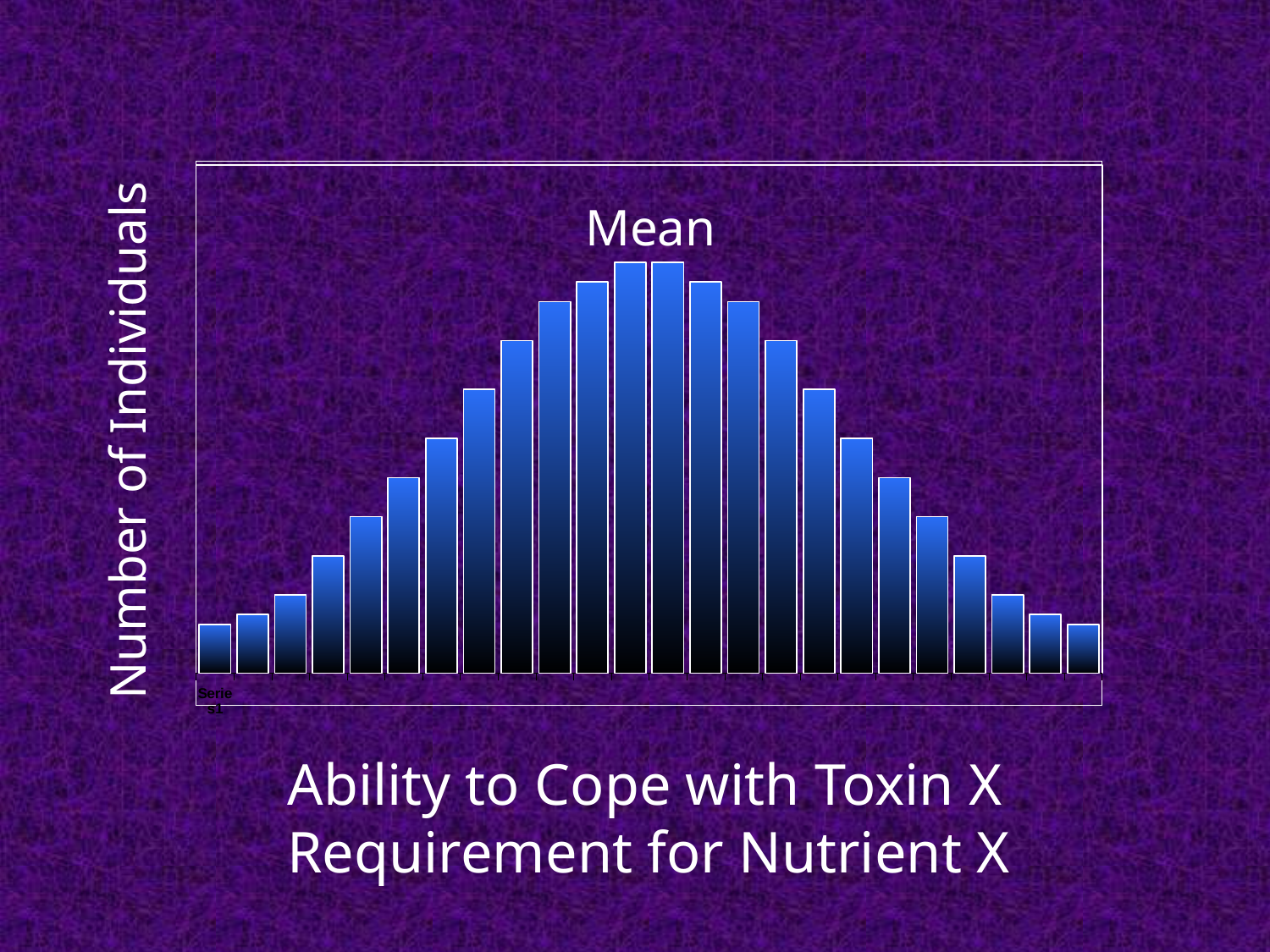
Are the bars in the middle of the chart taller or shorter than the bars at the left and right edges? taller What word is written above the tallest bars in the centre of the chart? Mean How many bars are plotted in the chart? 24 What kind of chart is shown on the slide? bar chart How do the bar heights change moving from left to right across the chart? rise then fall What is the label on the vertical axis of the chart? Number of Individuals